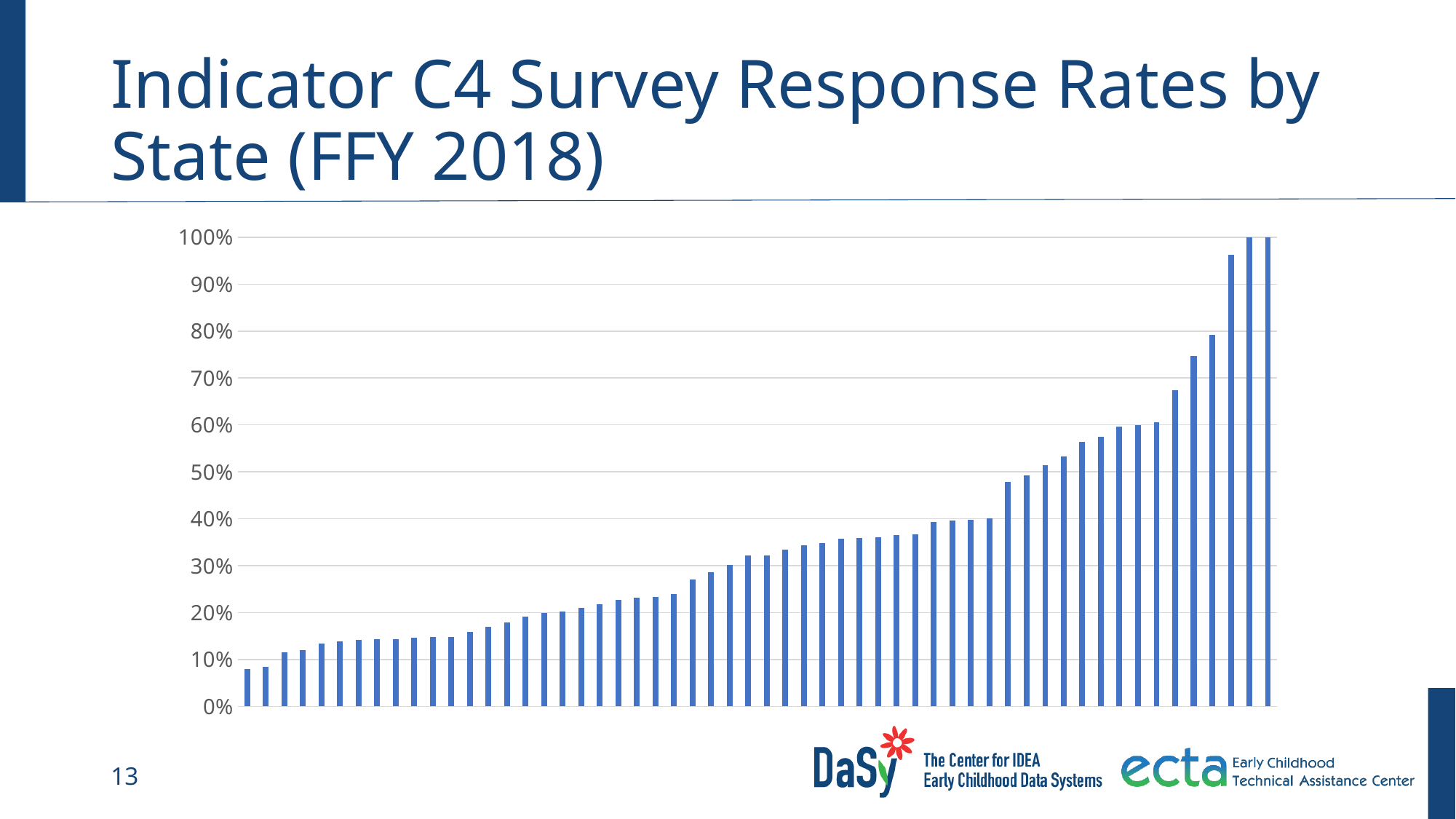
Is the value of the shortest (leftmost) bar greater or less than 10%? less What is the highest value reached by any bar in the chart? 100% What kind of chart is shown on the slide? bar chart What is the title of the chart on the slide? Indicator C4 Survey Response Rates by State (FFY 2018) What is the maximum value shown on the vertical axis? 100% What is the interval between tick marks on the vertical axis? 10% Which bar is larger, the leftmost bar or the rightmost bar? the rightmost bar Is the value of the third-tallest bar greater or less than 90%? greater Do the bar values rise or fall from left to right across the chart? rise Is the value of the leftmost bar greater or less than 20%? less